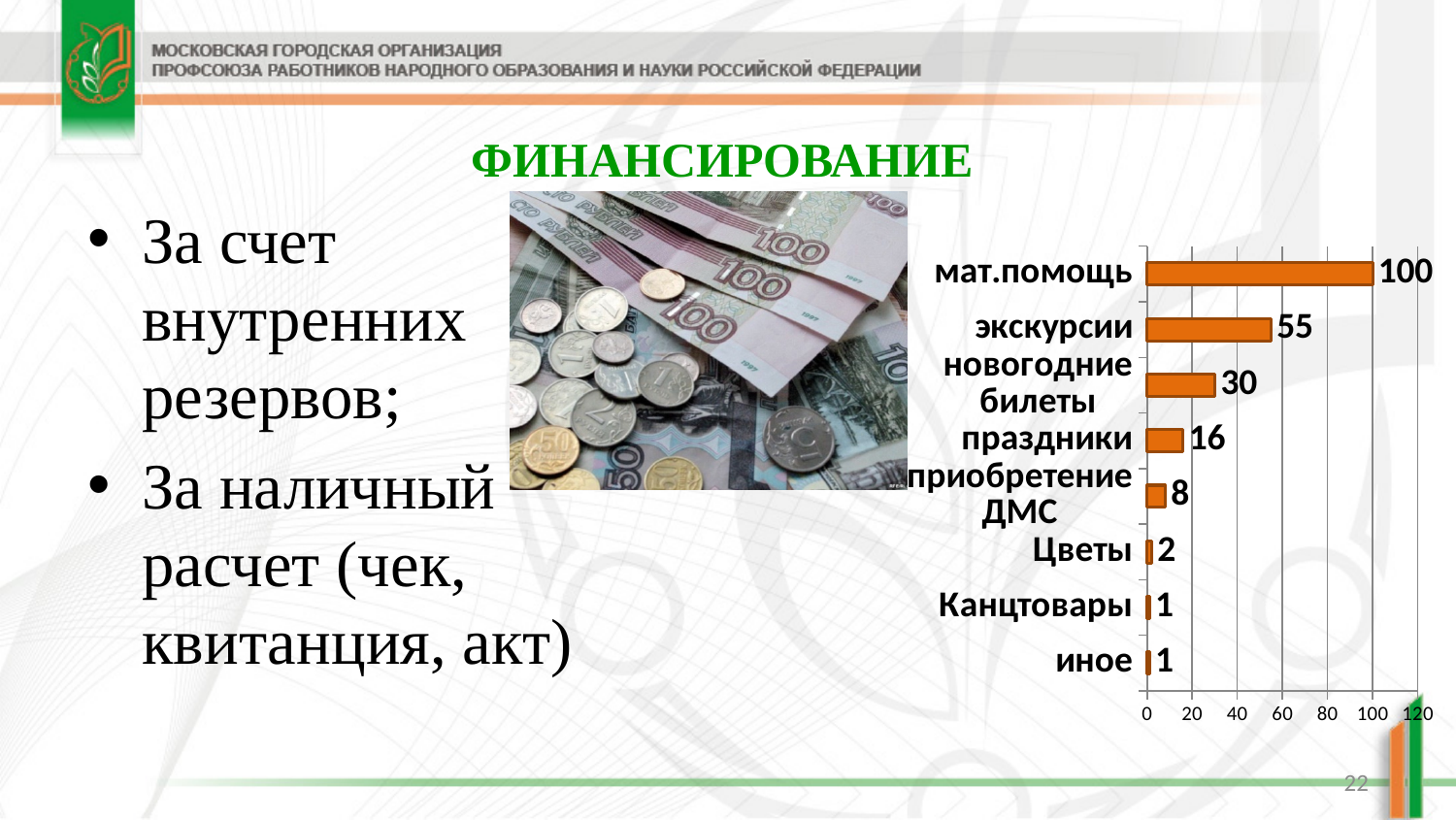
What is the highest value shown on the chart's horizontal axis? 120 Is the value for экскурсии greater or less than 40? greater What is the value for экскурсии? 55 Which category has the highest value? мат.помощь What is the difference between the values for мат.помощь and экскурсии? 45 What kind of chart is shown on the slide? bar chart What is the value for мат.помощь? 100 What is the difference between the values for новогодние билеты and праздники? 14 How many categories are shown in the chart? 8 What is the value for новогодние билеты? 30 Which is larger, the value for праздники or the value for Цветы? праздники What is the value for приобретение ДМС? 8